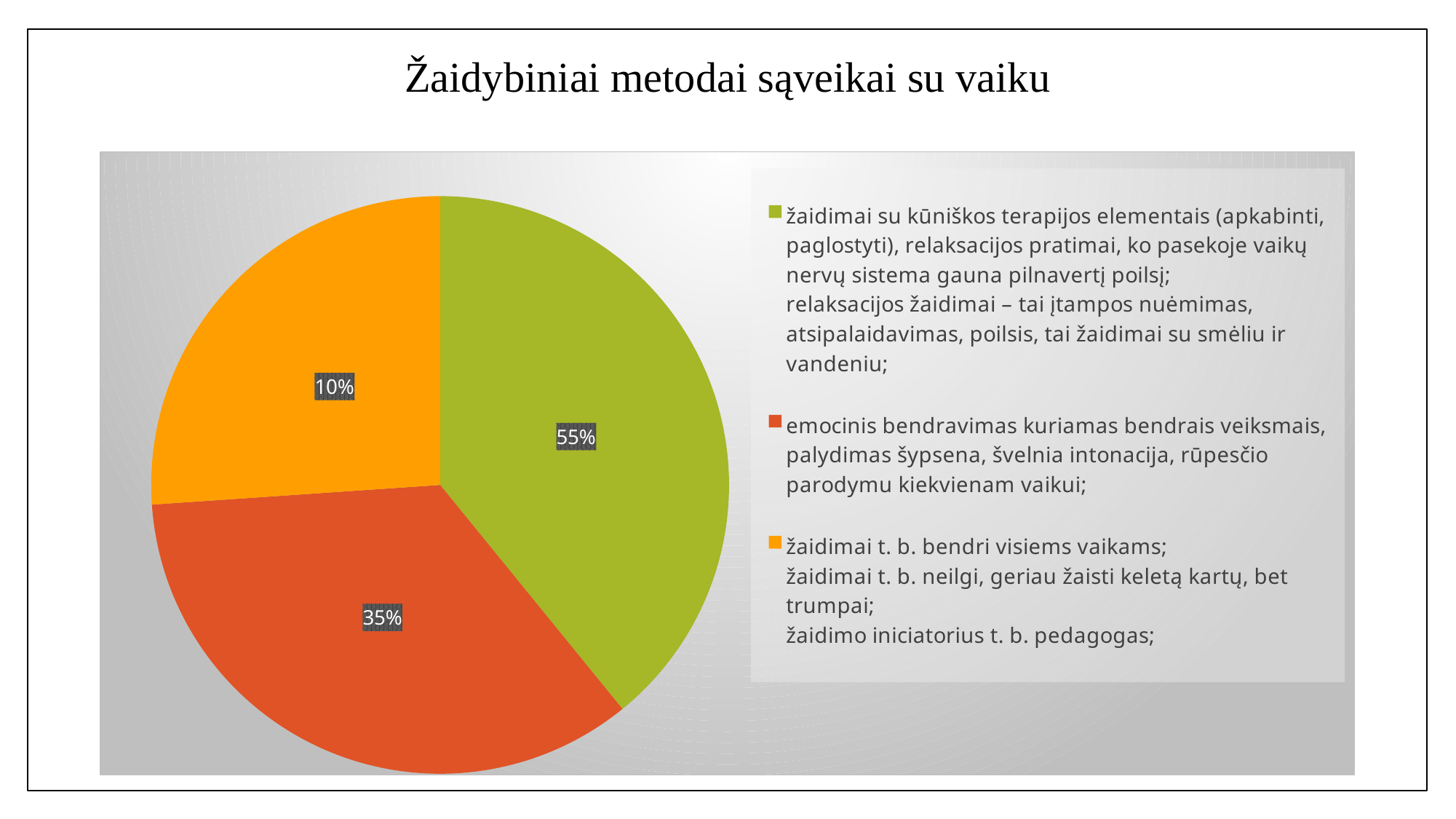
How many entries does the legend list? 3 What share of the pie is the slice for 'emocinis bendravimas kuriamas bendrais veiksmais' (red)? 35% What is the title of the chart on the slide? Žaidybiniai metodai sąveikai su vaiku Which legend category has the largest slice of the pie? žaidimai su kūniškos terapijos elementais (apkabinti, paglostyti), relaksacijos pratimai... What is the difference between the green slice (55%) and the red slice (35%)? 20% What kind of chart is shown on the slide? pie chart What is the difference between the red slice (35%) and the orange slice (10%)? 25% How many slices does the pie chart have? 3 Which legend category has the smallest slice of the pie? žaidimai t. b. bendri visiems vaikams... What share of the pie is the slice for 'žaidimai t. b. bendri visiems vaikams' (orange)? 10% Which is larger, the green slice or the orange slice? the green slice What share of the pie is the slice for 'žaidimai su kūniškos terapijos elementais' (green)? 55%